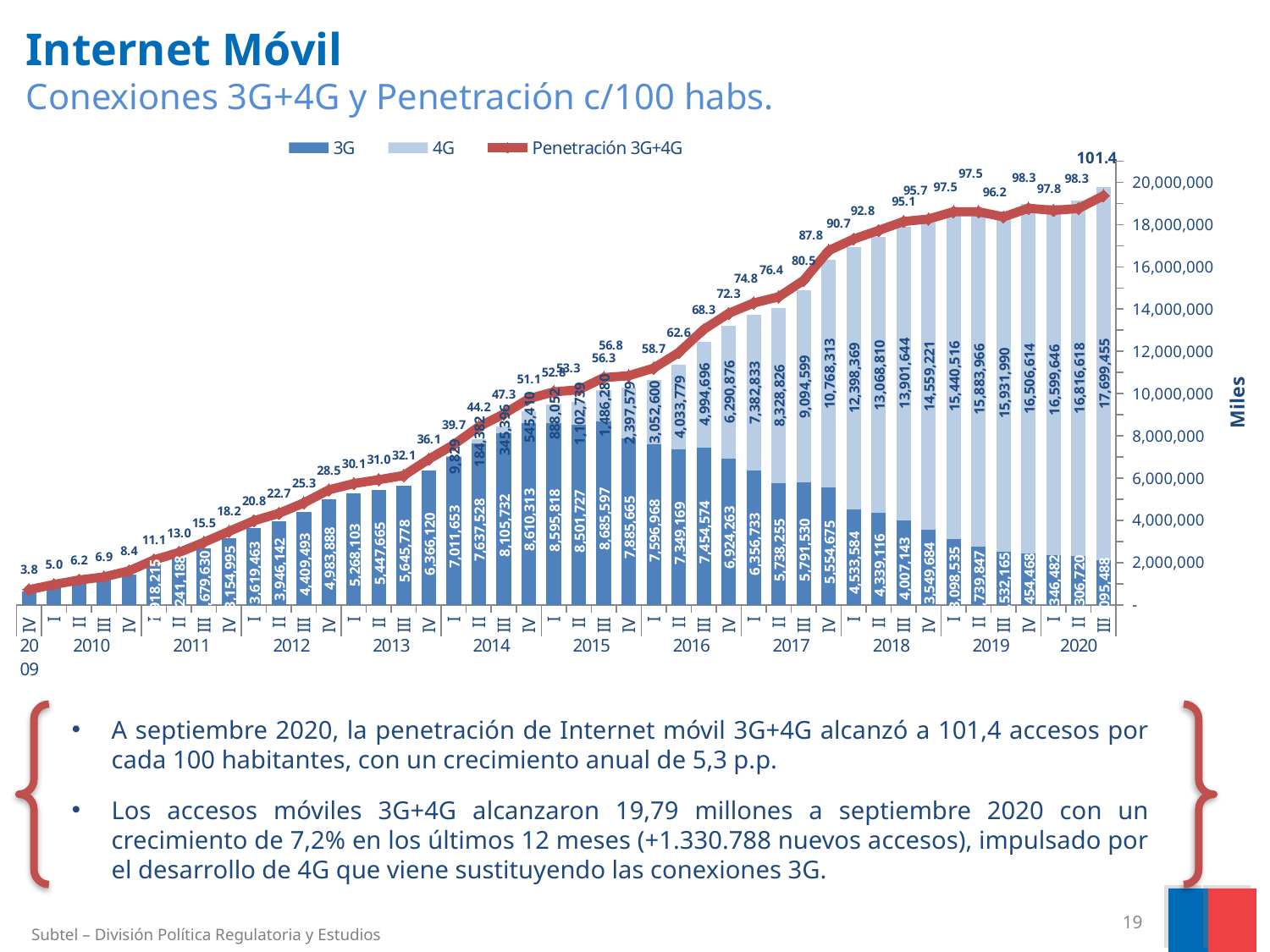
In which quarter is the Penetración 3G+4G value lowest? IV 2009 What is the Penetración 3G+4G value for quarter III of 2020? 101.4 In which quarter is the Penetración 3G+4G value highest? III 2020 What kind of chart is shown on the slide? Stacked bar chart with a line What is the 3G value for quarter III of 2015? 8,685,597 Does the Penetración 3G+4G line generally rise or fall from 2009 to 2020? Rise How many series does the legend list? 3 What is the difference between the 4G values for quarter III of 2020 and quarter II of 2020? 882,837 Which is larger in quarter I of 2016, the 3G value or the 4G value? 3G What is the label on the right-hand vertical axis? Miles What is the 4G value for quarter III of 2020? 17,699,455 What is the total of the stacked bar (3G plus 4G) for quarter I of 2018? 16,931,953